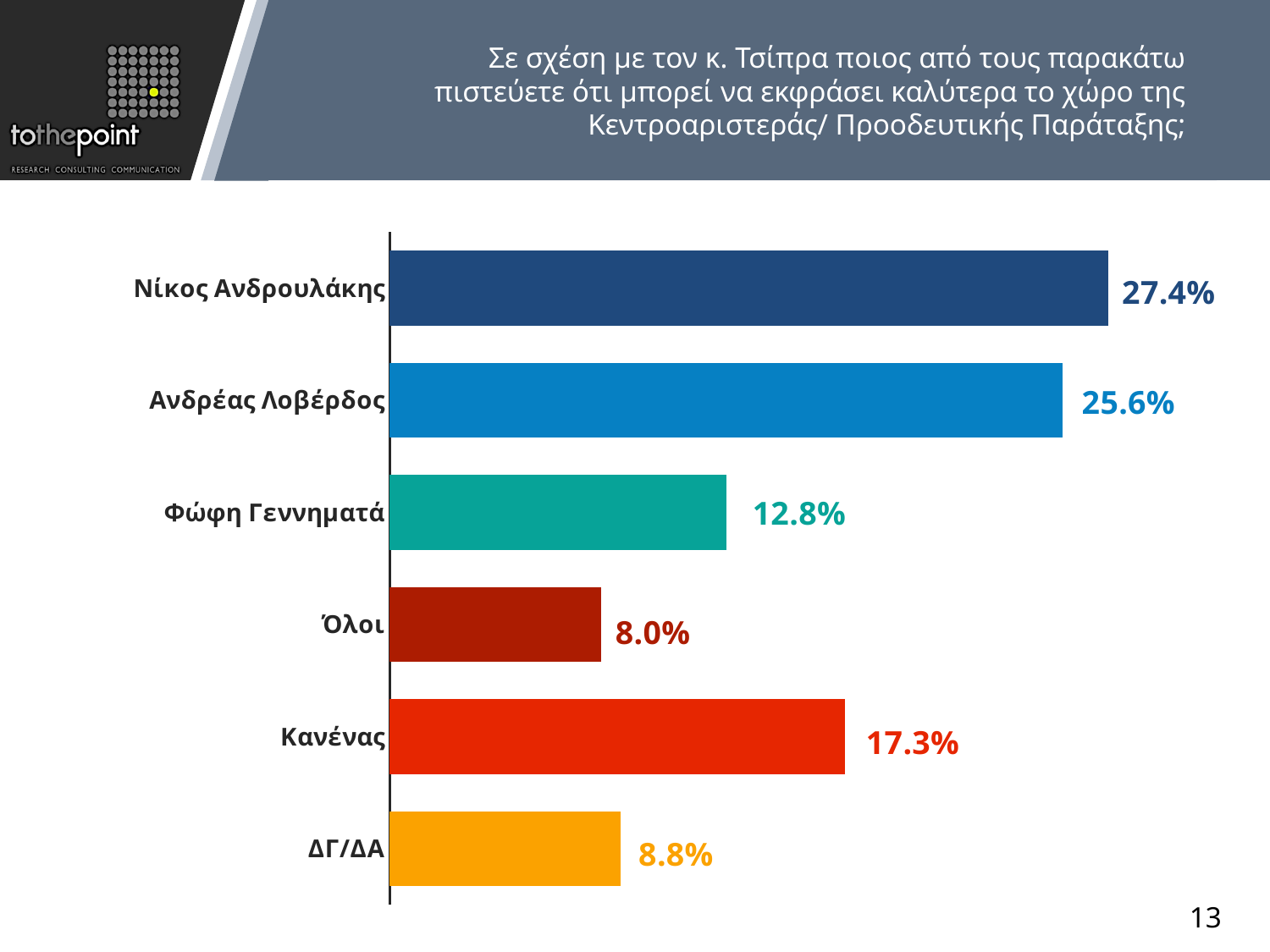
Which category has the highest value? Νίκος Ανδρουλάκης What is the value for ΔΓ/ΔΑ? 8.8% What is the value for Κανένας? 17.3% How many categories are shown in the chart? 6 What is the value for Ανδρέας Λοβέρδος? 25.6% Which is larger, the value for Κανένας or the value for Φώφη Γεννηματά? Κανένας What is the value for Φώφη Γεννηματά? 12.8% What is the value for Νίκος Ανδρουλάκης? 27.4% Which category has the lowest value? Όλοι What is the difference between the values for ΔΓ/ΔΑ and Όλοι? 0.8% What kind of chart is shown on the slide? Bar chart What is the difference between the values for Νίκος Ανδρουλάκης and Ανδρέας Λοβέρδος? 1.8%